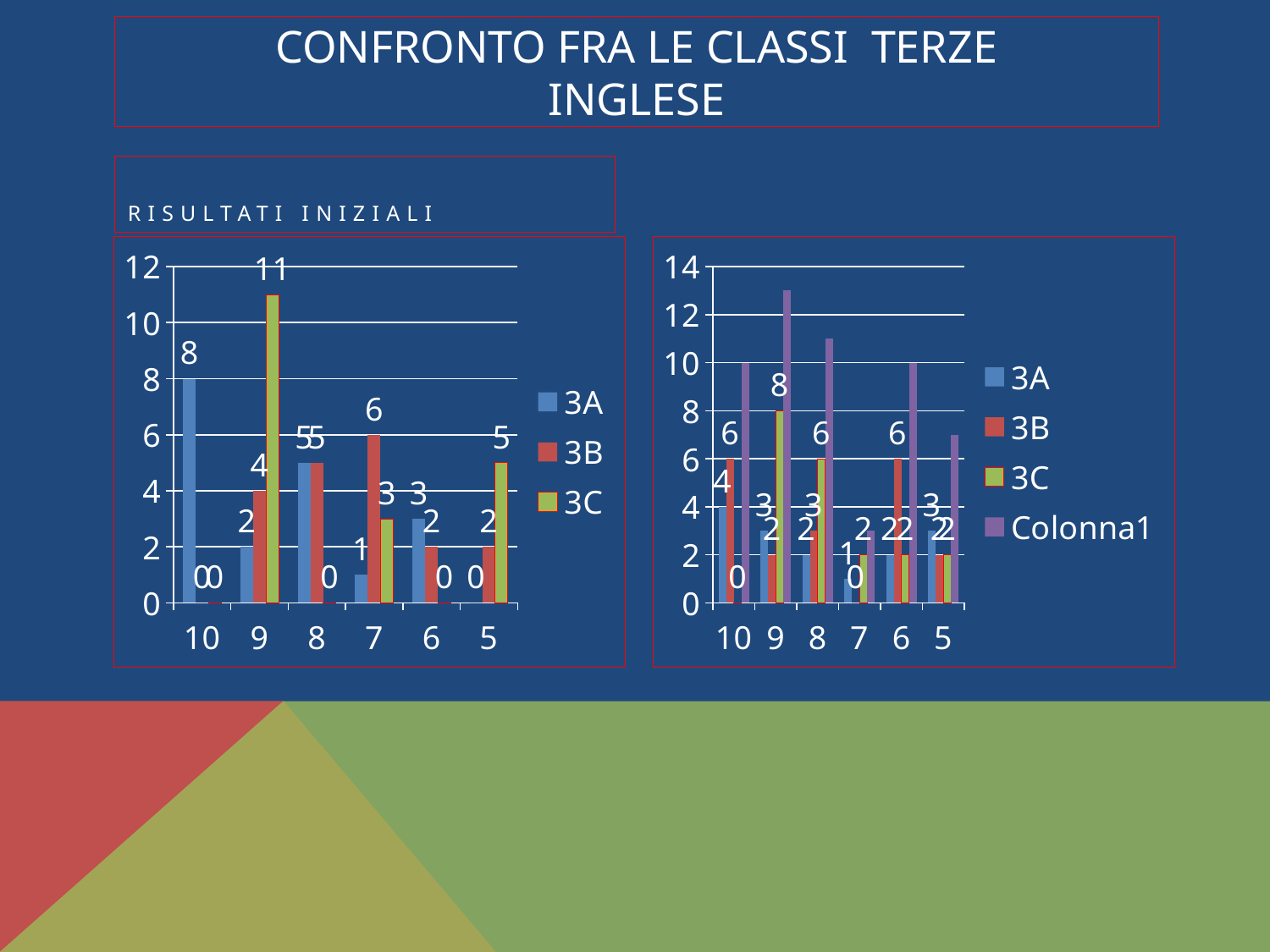
In the chart on the right, what is the value for 3C at category 9? 8 How many series does the legend of the chart on the right list? 4 In the chart on the right, is the value for Colonna1 at category 9 greater or less than 12? greater In the RISULTATI INIZIALI chart on the left, which category has the highest value for 3B? 7 In the RISULTATI INIZIALI chart on the left, what is the value for 3A at category 10? 8 How many categories are shown on the x axis of the chart on the right? 6 In the chart on the right, which category has the highest value for Colonna1? 9 In the RISULTATI INIZIALI chart on the left, what is the difference between the 3C value at category 9 and the 3C value at category 5? 6 How many series does the legend of the RISULTATI INIZIALI chart on the left list? 3 What kind of chart is the chart on the right? bar chart In the RISULTATI INIZIALI chart on the left, what is the value for 3C at category 9? 11 In the RISULTATI INIZIALI chart on the left, which is larger at category 7: the value for 3A or the value for 3B? 3B